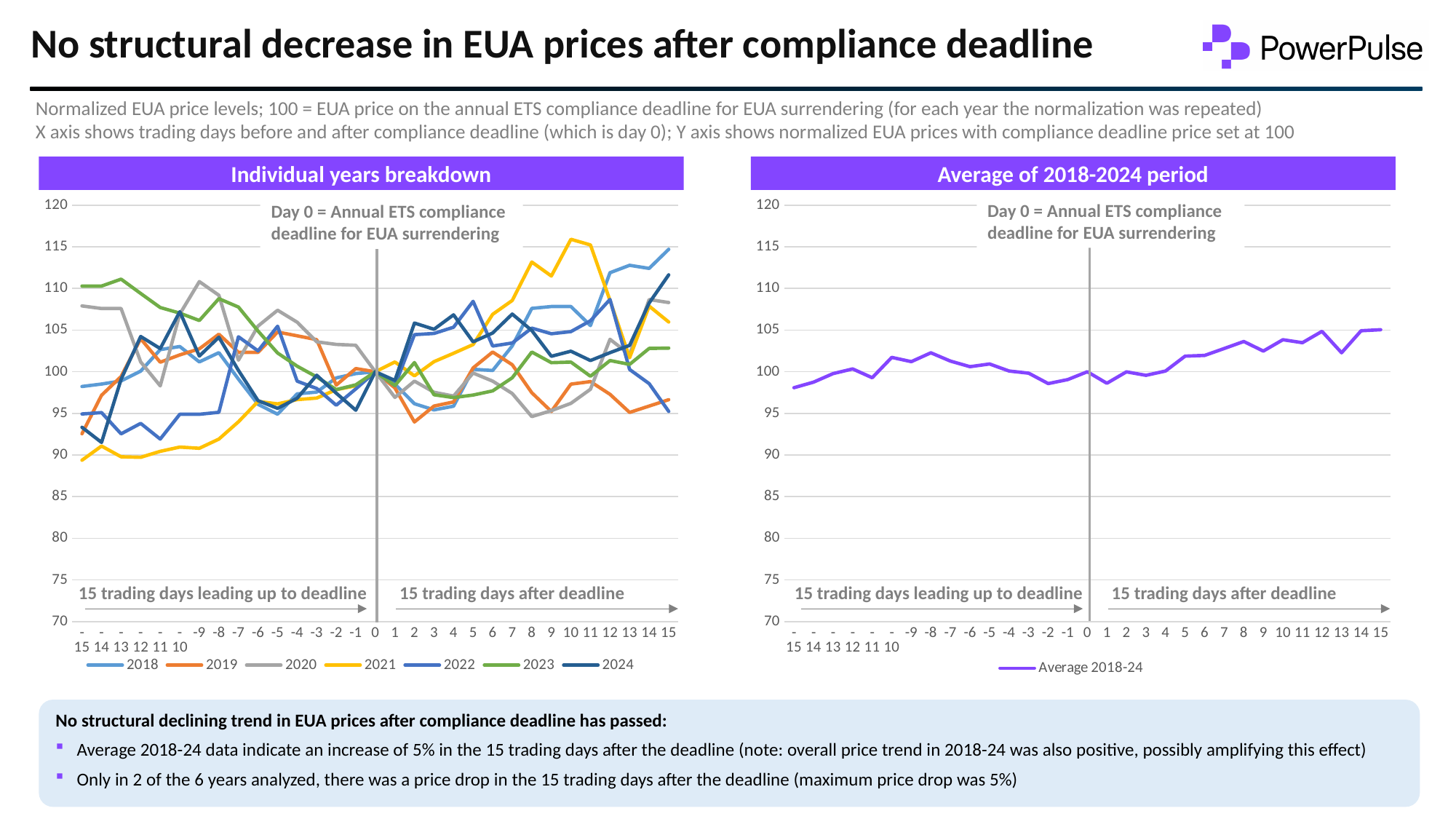
In the 'Individual years breakdown' chart, is the value for 2022 at day 15 greater or less than 100? less In the 'Average of 2018-2024 period' chart, is the value at day 15 greater or less than 100? greater In the 'Average of 2018-2024 period' chart, what is the value of Average 2018-24 at day 0? 100 What kind of chart is the 'Individual years breakdown' chart? Line chart How many series does the legend of the 'Average of 2018-2024 period' chart list? 1 In the 'Average of 2018-2024 period' chart, which is larger: the value at day 15 or the value at day -15? Day 15 In the 'Individual years breakdown' chart, which year has the highest value at day 10? 2021 In the 'Average of 2018-2024 period' chart, do values generally rise or fall from day 0 to day 15? Rise In the 'Average of 2018-2024 period' chart, is the value at day -15 greater or less than 100? less In the 'Individual years breakdown' chart, which year has the highest value at day 15? 2018 How many series does the legend of the 'Individual years breakdown' chart list? 7 What is the title of the left chart? Individual years breakdown